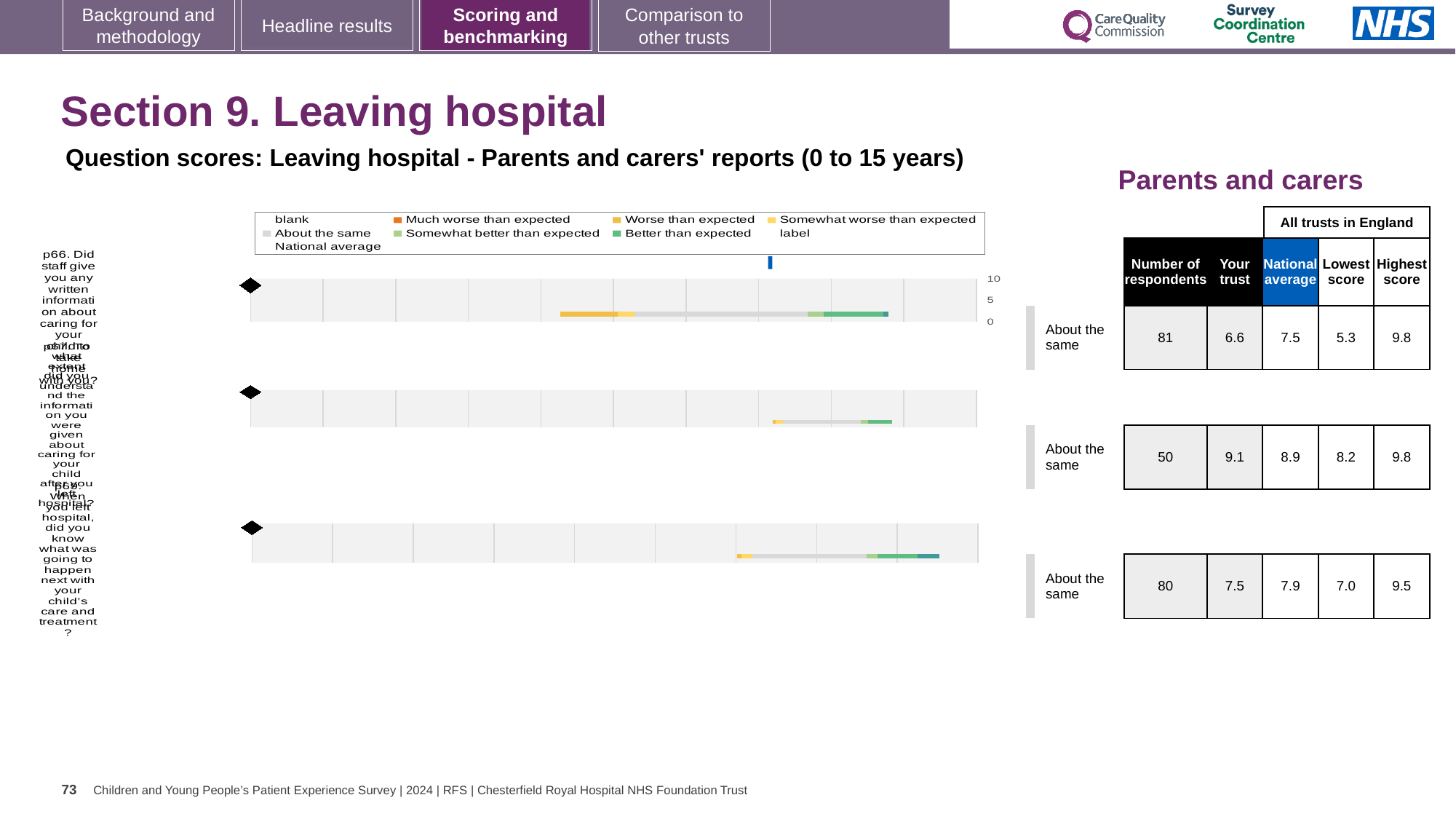
What benchmark category is shown for the third question row (p68)? About the same In the legend, what colour represents 'Much worse than expected'? orange What is the title of the chart on this slide? Question scores: Leaving hospital - Parents and carers' reports (0 to 15 years) For the second question row (p67), which is larger: the 'Your trust' score or the national average? Your trust How many question rows (bars) are plotted in the Leaving hospital chart? 3 What is the number of respondents for the first question row (p66)? 81 Which question row has the lowest number of respondents? the second row (p67), 50 What is the national average for the third question row (p68)? 7.9 Which question row has the highest 'Your trust' score? the second row (p67), 9.1 What is the 'Your trust' score for the second question row (p67)? 9.1 For the first question row (p66), what is the difference between the highest score and the lowest score across all trusts in England? 4.5 What kind of chart is used to show the question scores for Leaving hospital? bar chart